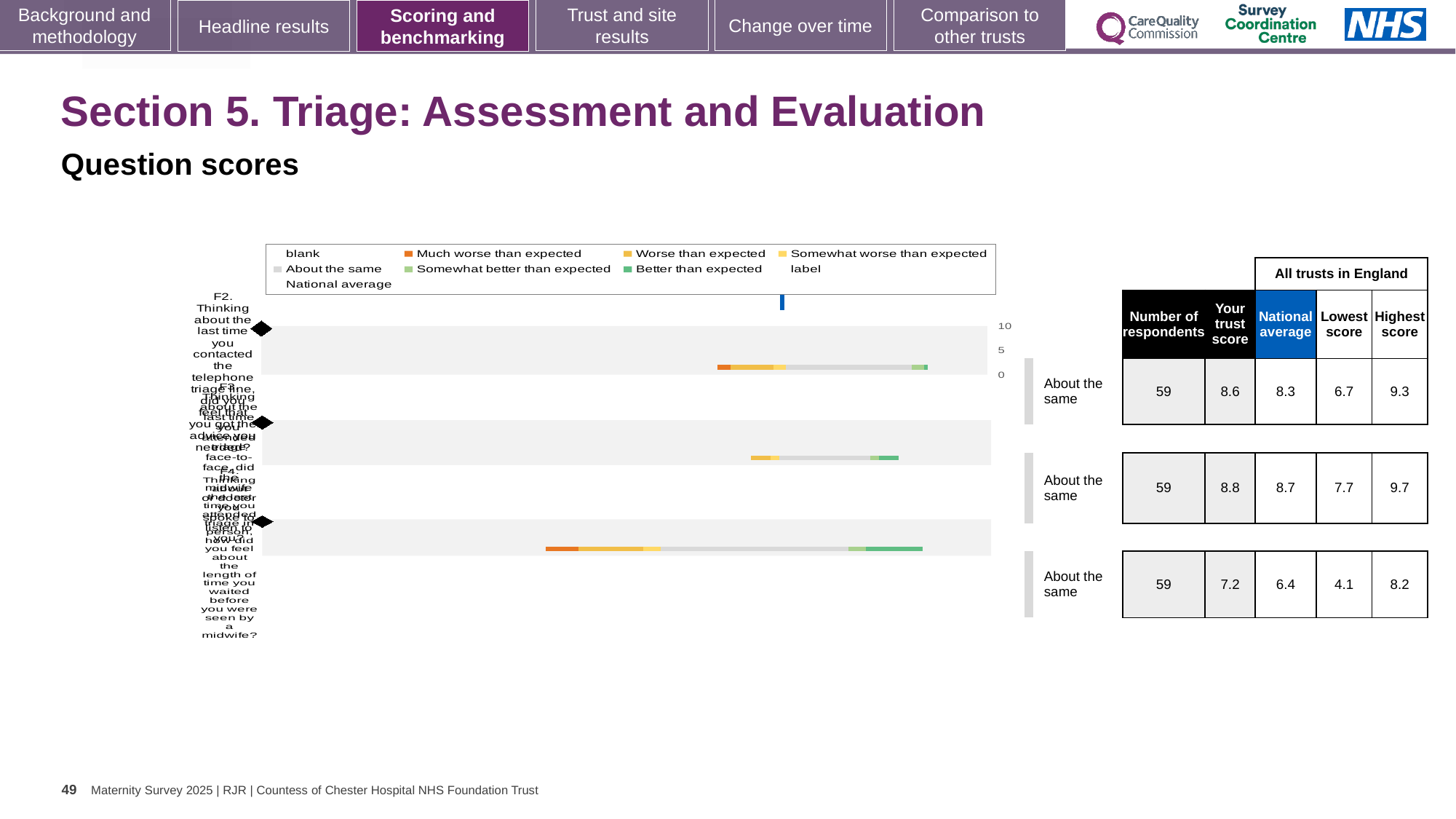
In the table, which row has the highest 'Your trust score'? second row (8.8) In the table, what is the highest score for the second row? 9.7 How many entries does the chart legend list? 9 In the table, what is the lowest score for the third row? 4.1 In the table, what is the difference between 'Your trust score' and the national average in the third row? 0.8 In the table, what is the national average for the second row? 8.7 How many bars (questions) are plotted in the chart? 3 What kind of chart is shown on the slide? bar chart What is the highest tick value shown on the chart's axis? 10 In the table, for the third row, which is larger: 'Your trust score' or the national average? Your trust score In the table, what is 'Your trust score' for the first row? 8.6 In the table, what is the number of respondents for the first row? 59